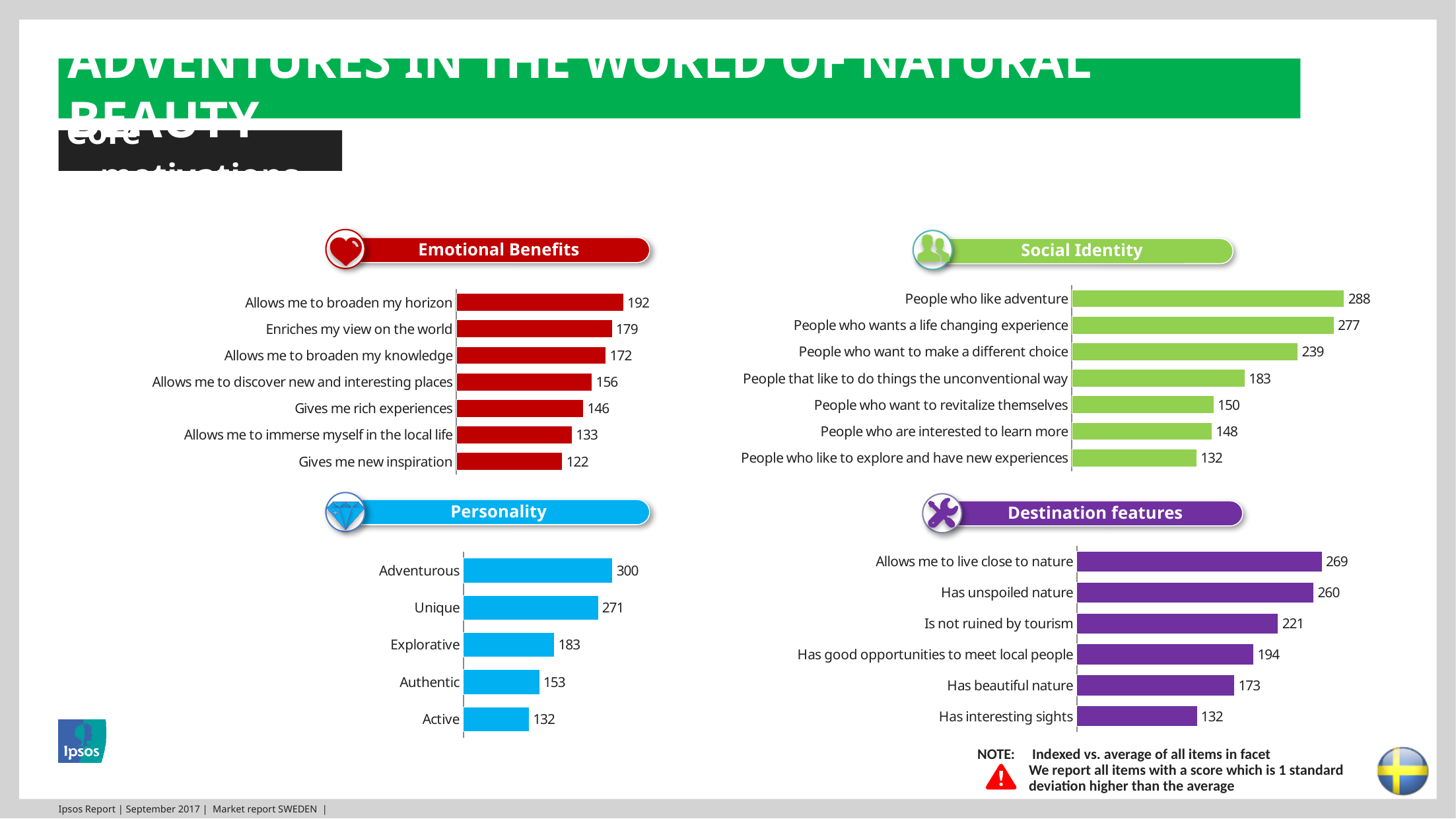
In the Destination features chart, what is the difference between "Allows me to live close to nature" and "Has interesting sights"? 137 How many categories are shown in the Social Identity chart? 7 In the Personality chart, what is the value for "Explorative"? 183 In the Emotional Benefits chart, what is the value for "Allows me to broaden my horizon"? 192 In the Social Identity chart, what is the difference between "People who like adventure" and "People who wants a life changing experience"? 11 In the Destination features chart, what is the value for "Is not ruined by tourism"? 221 In the Social Identity chart, what is the value for "People who want to make a different choice"? 239 How many categories are shown in the Personality chart? 5 In the Destination features chart, which is larger: "Has good opportunities to meet local people" or "Has beautiful nature"? Has good opportunities to meet local people In the Social Identity chart, which category has the highest value? People who like adventure In the Emotional Benefits chart, which category has the lowest value? Gives me new inspiration What type of chart is the Emotional Benefits chart? Bar chart